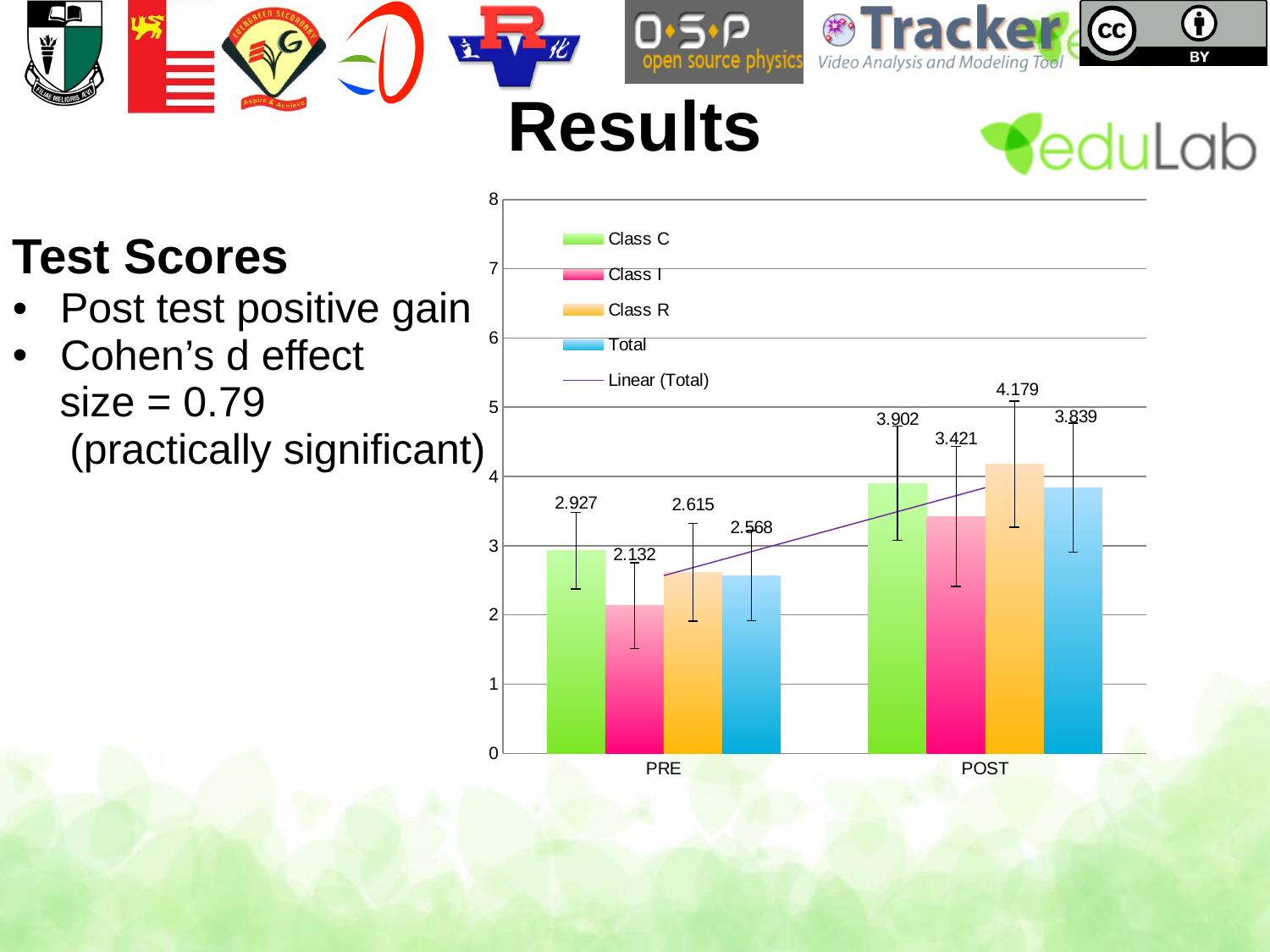
What is the value for Class R in the POST category? 4.179 What is the difference between the Total POST value and the Total PRE value? 1.271 How many categories are shown on the x axis? 2 What is the Total value for the PRE category? 2.568 What is the value for Class C in the PRE category? 2.927 What kind of chart is shown on the slide? Bar chart How many entries does the legend list? 5 What is the value for Class I in the POST category? 3.421 Which series has the highest value in the POST category? Class R What is the difference between the Class C POST value and the Class C PRE value? 0.975 Which series has the lowest value in the PRE category? Class I Which is larger: the Class R PRE value or the Class C PRE value? Class C PRE